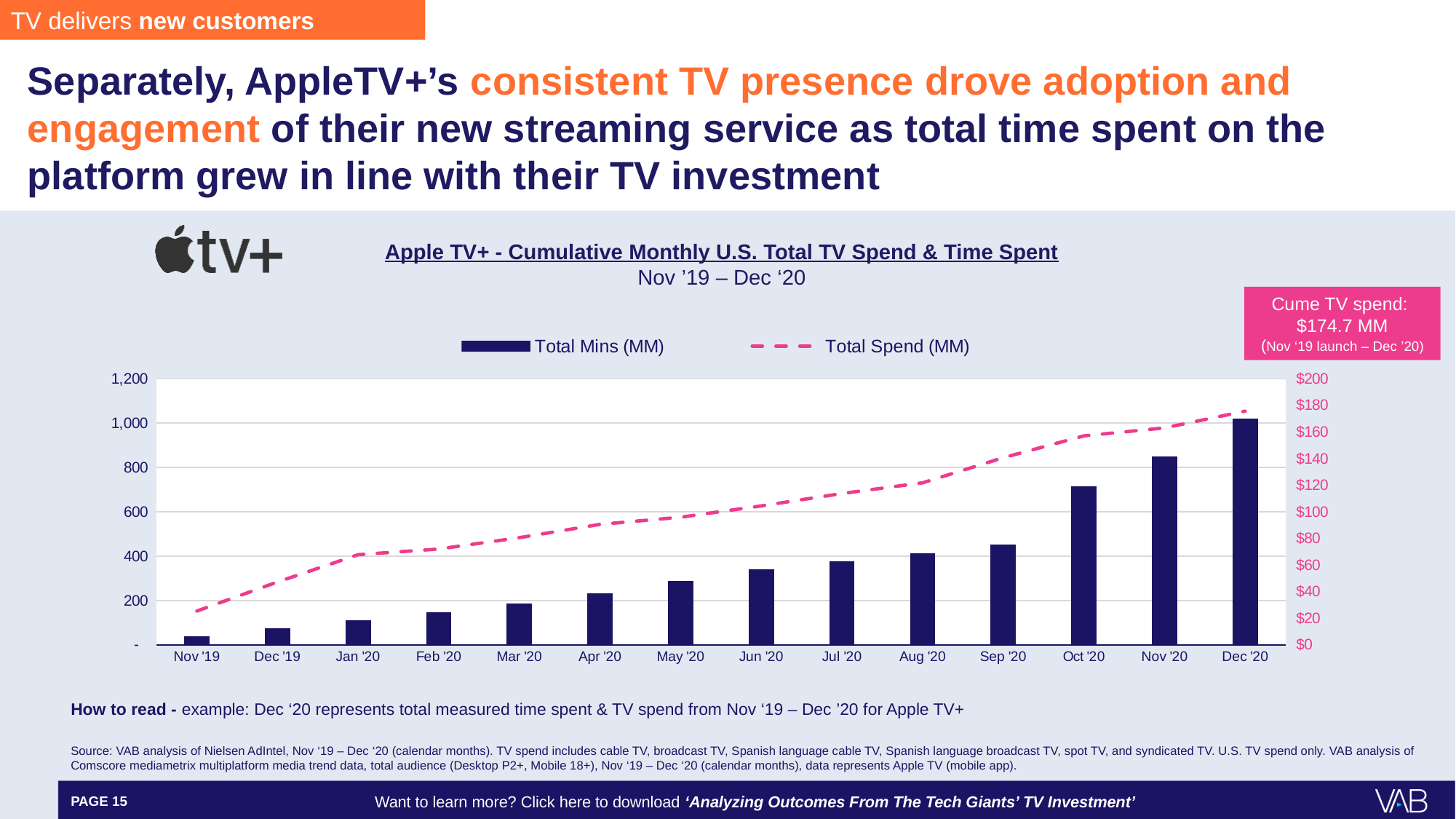
Which month has the highest Total Mins (MM)? Dec '20 Is the Total Spend (MM) value for Nov '19 greater or less than $40? less Is the Total Spend (MM) value for Dec '20 greater or less than $160? greater Is the Total Mins (MM) value for Jun '20 greater or less than 400? less What is the title of the chart? Apple TV+ - Cumulative Monthly U.S. Total TV Spend & Time Spent Which month has the larger Total Mins (MM), Oct '20 or Nov '20? Nov '20 Do the Total Mins (MM) bars rise or fall from Nov '19 to Dec '20? rise Which month has the lowest Total Mins (MM)? Nov '19 How many series does the legend list? 2 How many months are shown on the x axis? 14 What kind of chart is used to show Total Mins (MM)? bar chart